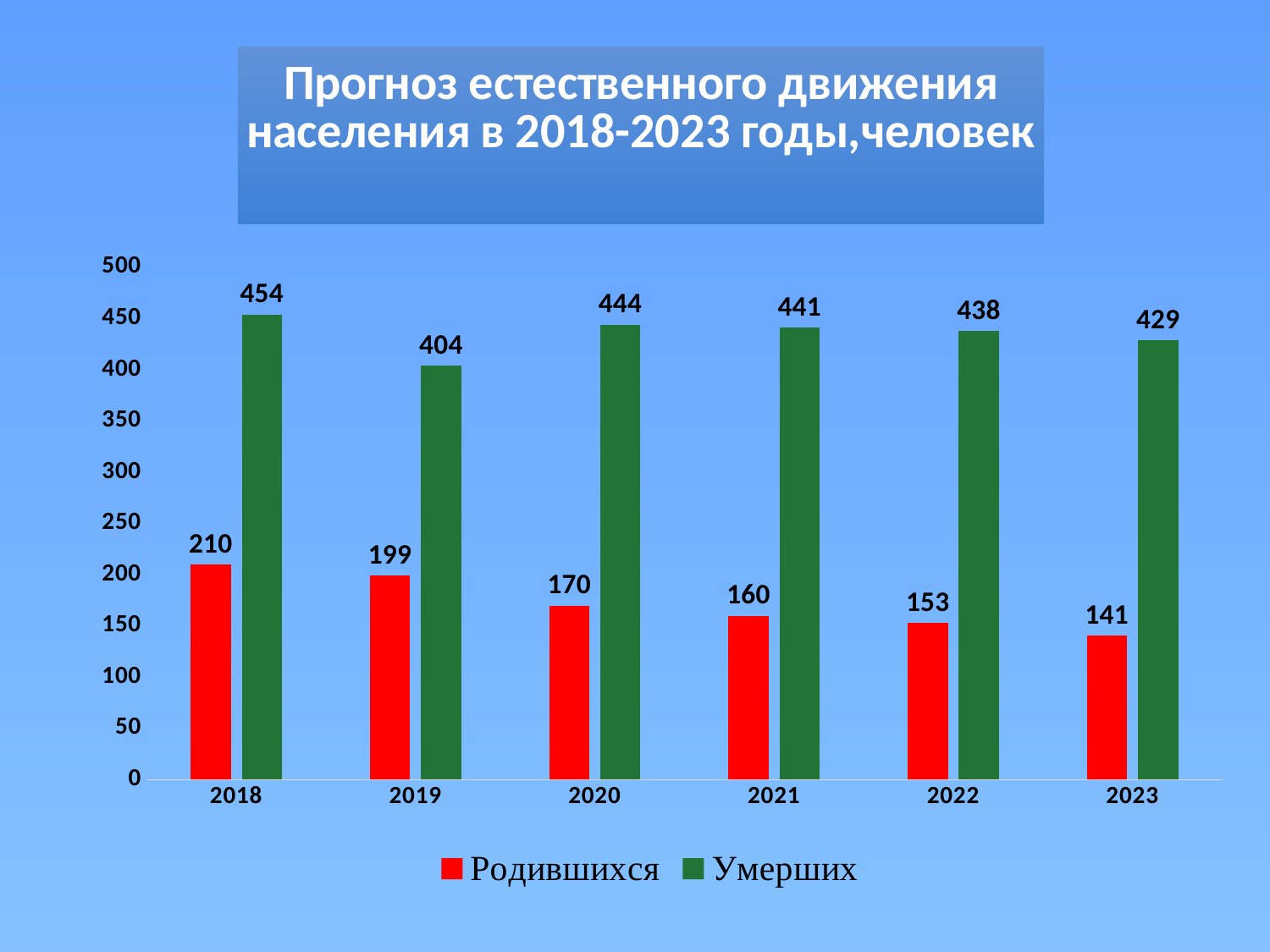
What is the value for Умерших in 2021? 441 How many series does the legend list? 2 Which is larger in 2022: Родившихся or Умерших? Умерших What is the difference between Умерших and Родившихся in 2020? 274 What kind of chart is shown on the slide? Bar chart What is the value for Родившихся in 2018? 210 What is the value for Родившихся in 2023? 141 In which year is the value for Родившихся the highest? 2018 Which colour represents Умерших in the legend? Green Do the values for Родившихся rise or fall from 2018 to 2023? Fall How many years are shown on the x axis? 6 In which year is the value for Умерших the lowest? 2019